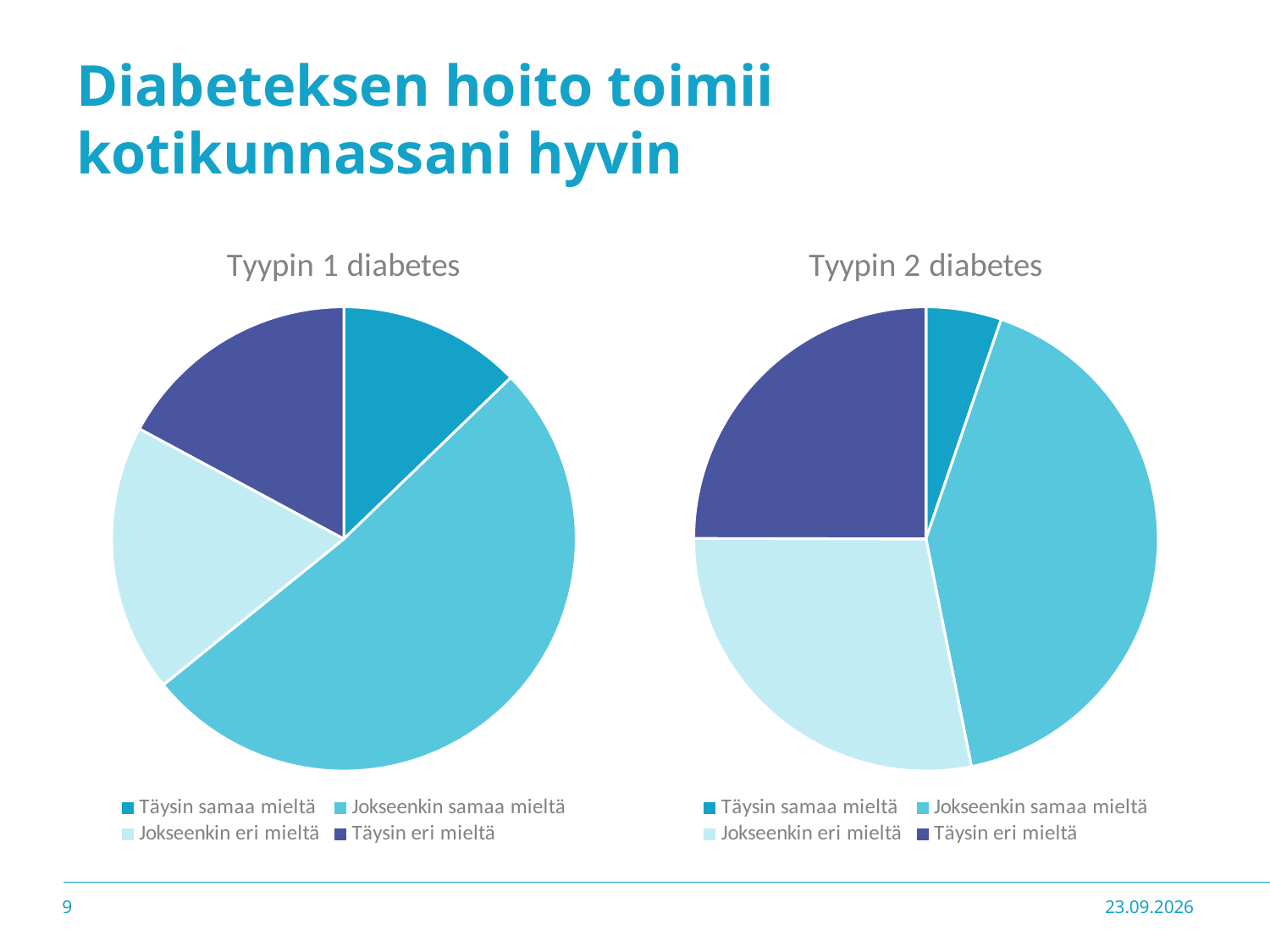
How many slices does the 'Tyypin 2 diabetes' pie chart have? 4 In the 'Tyypin 1 diabetes' chart, which slice is larger: 'Jokseenkin samaa mieltä' or 'Jokseenkin eri mieltä'? Jokseenkin samaa mieltä In the 'Tyypin 2 diabetes' chart, which category has the smallest slice? Täysin samaa mieltä In the 'Tyypin 1 diabetes' chart, which category has the largest slice? Jokseenkin samaa mieltä How many slices does the 'Tyypin 1 diabetes' pie chart have? 4 What kind of chart is the 'Tyypin 2 diabetes' chart? Pie chart What is the title of the chart on the left side of the slide? Tyypin 1 diabetes In the 'Tyypin 2 diabetes' chart, which slice is larger: 'Täysin samaa mieltä' or 'Täysin eri mieltä'? Täysin eri mieltä In the 'Tyypin 2 diabetes' chart, which category has the largest slice? Jokseenkin samaa mieltä What kind of chart is the 'Tyypin 1 diabetes' chart? Pie chart What is the title of the chart on the right side of the slide? Tyypin 2 diabetes How many entries does the legend of the 'Tyypin 2 diabetes' chart list? 4